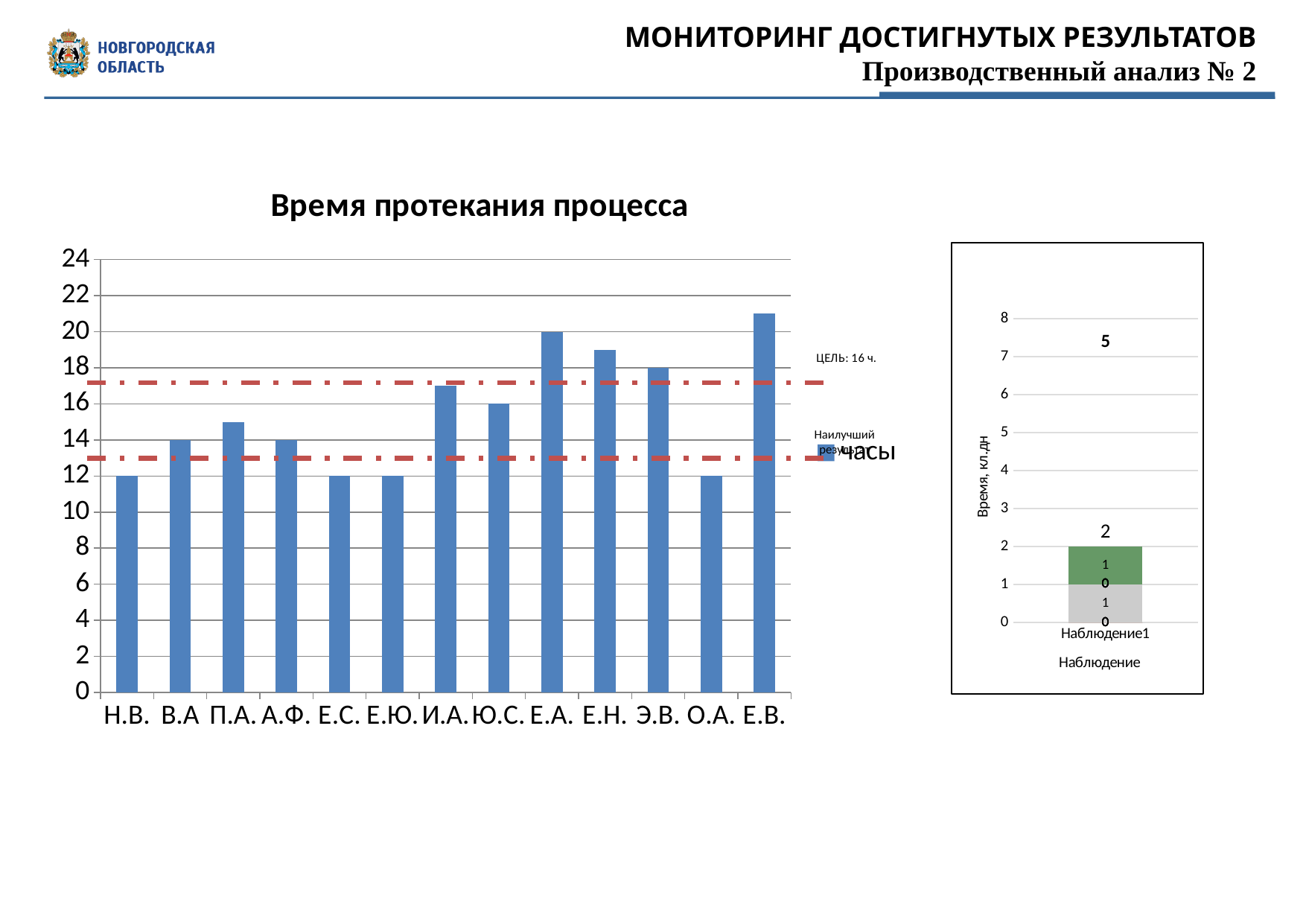
On the chart titled 'Время протекания процесса', what is the value for Ю.С.? 16 On the chart titled 'Время протекания процесса', what is the difference between the values for Е.А. and Н.В.? 8 On the chart titled 'Время протекания процесса', which is larger, the value for Е.А. or the value for Ю.С.? Е.А. On the small chart on the right of the slide, what is the total of the stacked bar for Наблюдение1? 2 On the chart titled 'Время протекания процесса', is the value for П.А. greater or less than 16? less What kind of chart is the chart titled 'Время протекания процесса'? bar chart What is the y-axis title of the small chart on the right of the slide? Время, кл.дн On the chart titled 'Время протекания процесса', what is the value for Э.В.? 18 How many categories are shown on the x axis of the chart titled 'Время протекания процесса'? 13 On the chart titled 'Время протекания процесса', is the value for Е.Н. greater or less than 18? greater On the chart titled 'Время протекания процесса', what is the value for Е.А.? 20 On the chart titled 'Время протекания процесса', what is the value for Н.В.? 12